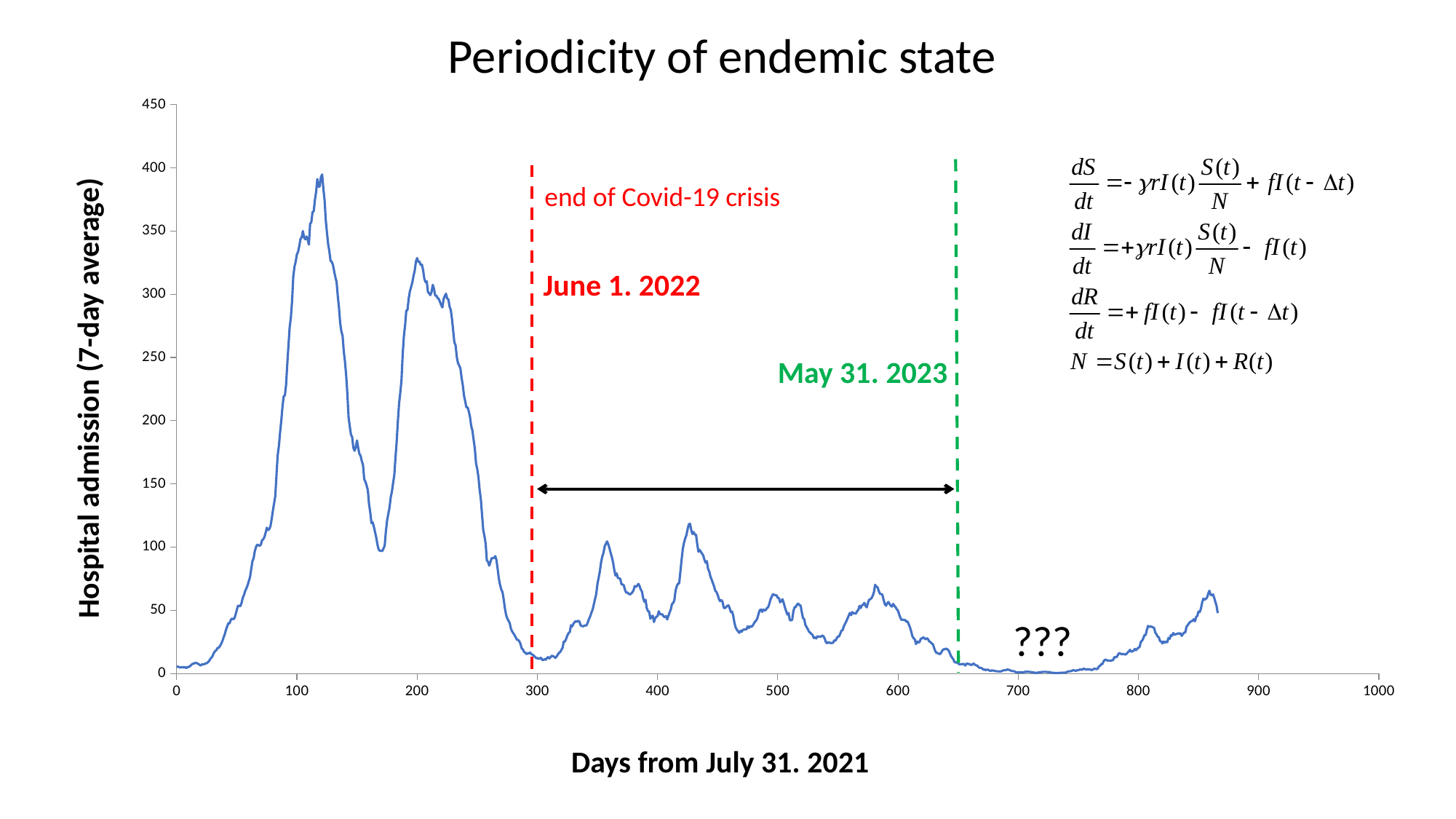
Which is larger, the value at day 100 or the value at day 500? day 100 Does the line rise or fall between day 120 and day 170? fall Is the value at day 600 greater or less than 100? less Is the value at day 300 greater or less than 50? less How many data series are plotted on the chart? 1 What is the label of the x axis? Days from July 31. 2021 Is the highest value of the line greater or less than 350? greater What kind of chart is shown on the slide? line chart What is the title of the chart? Periodicity of endemic state Which is larger, the peak near day 120 or the peak near day 200? the peak near day 120